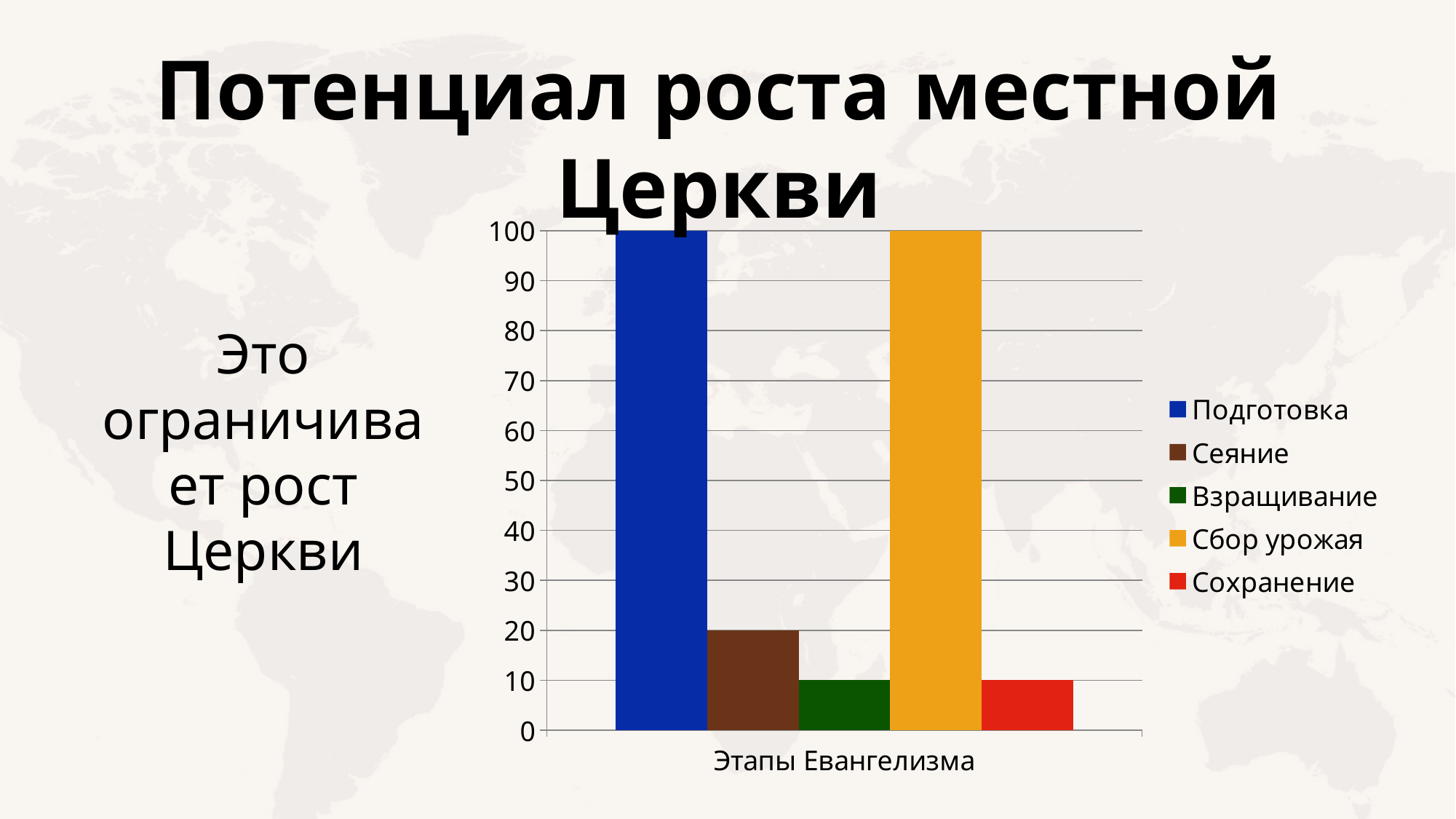
How many series does the legend list? 5 What type of chart is shown on the slide? bar chart Is the value for Сеяние greater or less than 50? less What is the value for Сохранение? 10 Which is larger, the value for Сеяние or the value for Взращивание? Сеяние What is the value for Сбор урожая? 100 What is the label on the x axis of the chart? Этапы Евангелизма What is the value for Взращивание? 10 What is the value for Сеяние? 20 What colour is the bar for Сбор урожая? orange What is the value for Подготовка? 100 What is the difference between the value for Подготовка and the value for Сеяние? 80